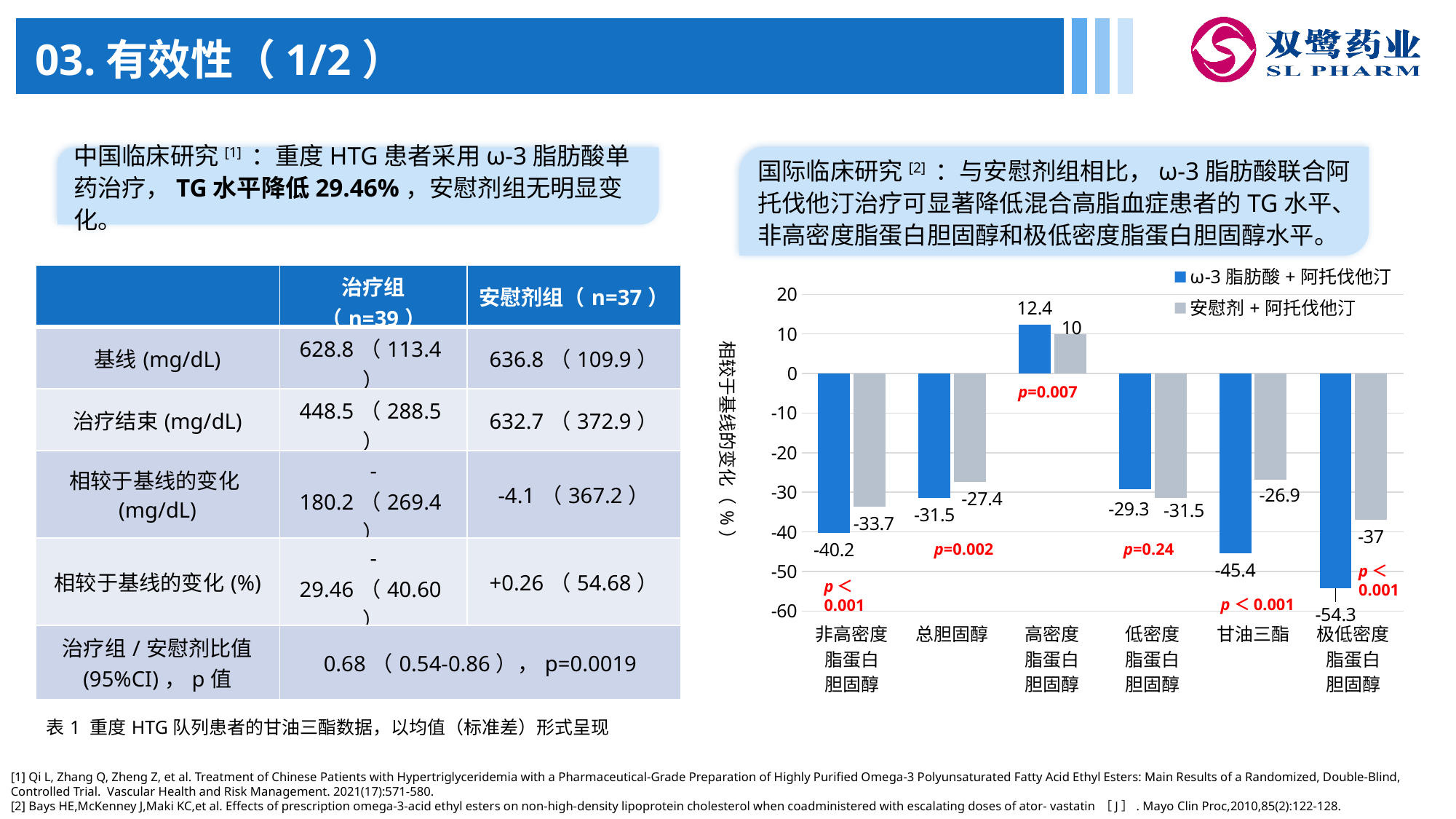
What is the value for 极低密度脂蛋白胆固醇 in the 安慰剂 + 阿托伐他汀 series? -37 Which category has the lowest value in the ω-3 脂肪酸 + 阿托伐他汀 series? 极低密度脂蛋白胆固醇 What is the difference between the ω-3 脂肪酸 + 阿托伐他汀 value and the 安慰剂 + 阿托伐他汀 value for 甘油三酯? 18.5 How many series does the chart legend list? 2 For 低密度脂蛋白胆固醇, which series has the larger value: ω-3 脂肪酸 + 阿托伐他汀 or 安慰剂 + 阿托伐他汀? ω-3 脂肪酸 + 阿托伐他汀 What type of chart is shown on the slide? bar chart Is the value for 非高密度脂蛋白胆固醇 in the ω-3 脂肪酸 + 阿托伐他汀 series greater or less than -30? less What is the value for 高密度脂蛋白胆固醇 in the 安慰剂 + 阿托伐他汀 series? 10 How many categories are shown on the x axis of the chart? 6 What is the value for 甘油三酯 in the ω-3 脂肪酸 + 阿托伐他汀 series? -45.4 What p value is printed on the chart for 总胆固醇? p=0.002 Which category has the highest value in the 安慰剂 + 阿托伐他汀 series? 高密度脂蛋白胆固醇